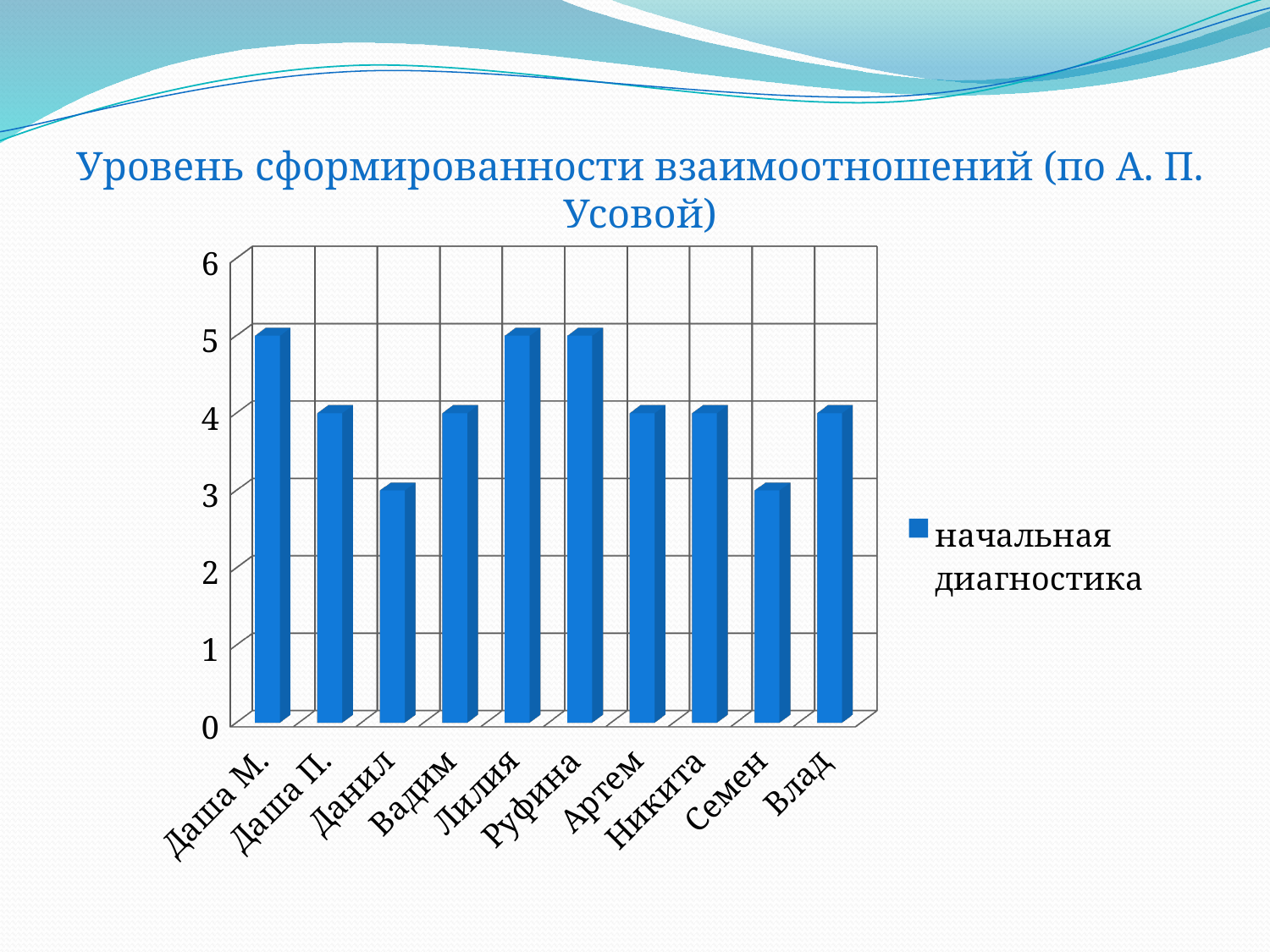
How many categories are shown on the x axis? 10 What is the value for Данил? 3 What is the value for Никита? 4 How many series does the legend list? 1 What is the legend entry of the chart? начальная диагностика What is the value for Даша М.? 5 What kind of chart is shown on the slide? bar chart Which is larger, the value for Лилия or the value for Вадим? Лилия Which is larger, the value for Семен or the value for Влад? Влад Is the value for Данил greater or less than 4? less What is the difference between the values for Руфина and Данил? 2 What is the value for Семен? 3